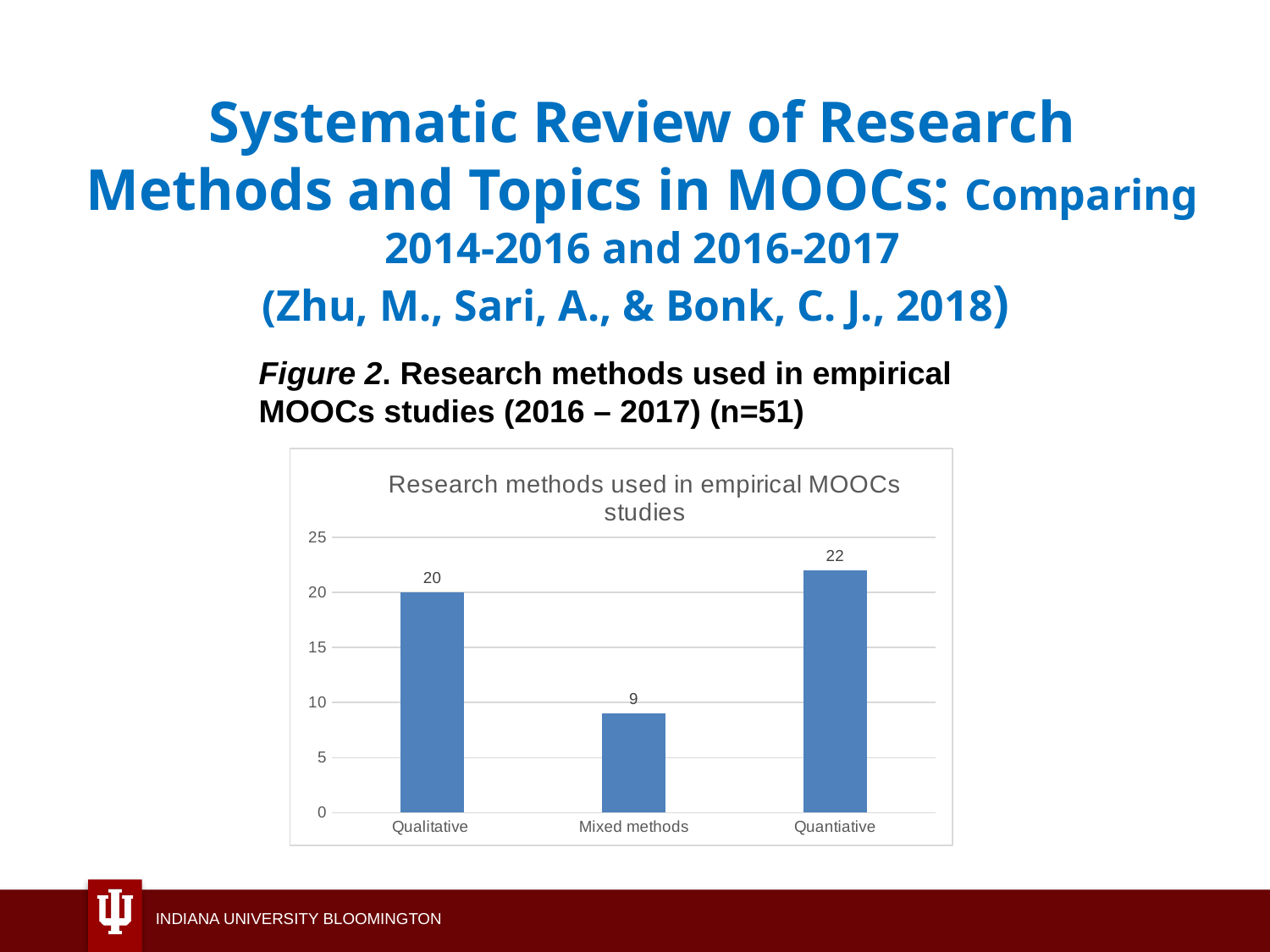
What is the value for Quantiative? 22 What is the value for Qualitative? 20 How many categories are shown on the x axis? 3 Is the value for Mixed methods greater or less than 10? less What kind of chart is shown on the slide? bar chart What is the title of the chart? Research methods used in empirical MOOCs studies What is the difference between the values for Quantiative and Qualitative? 2 What is the difference between the values for Qualitative and Mixed methods? 11 Which research method has the highest value? Quantiative Which research method has the lowest value? Mixed methods Which is larger, the value for Qualitative or the value for Mixed methods? Qualitative What is the value for Mixed methods? 9